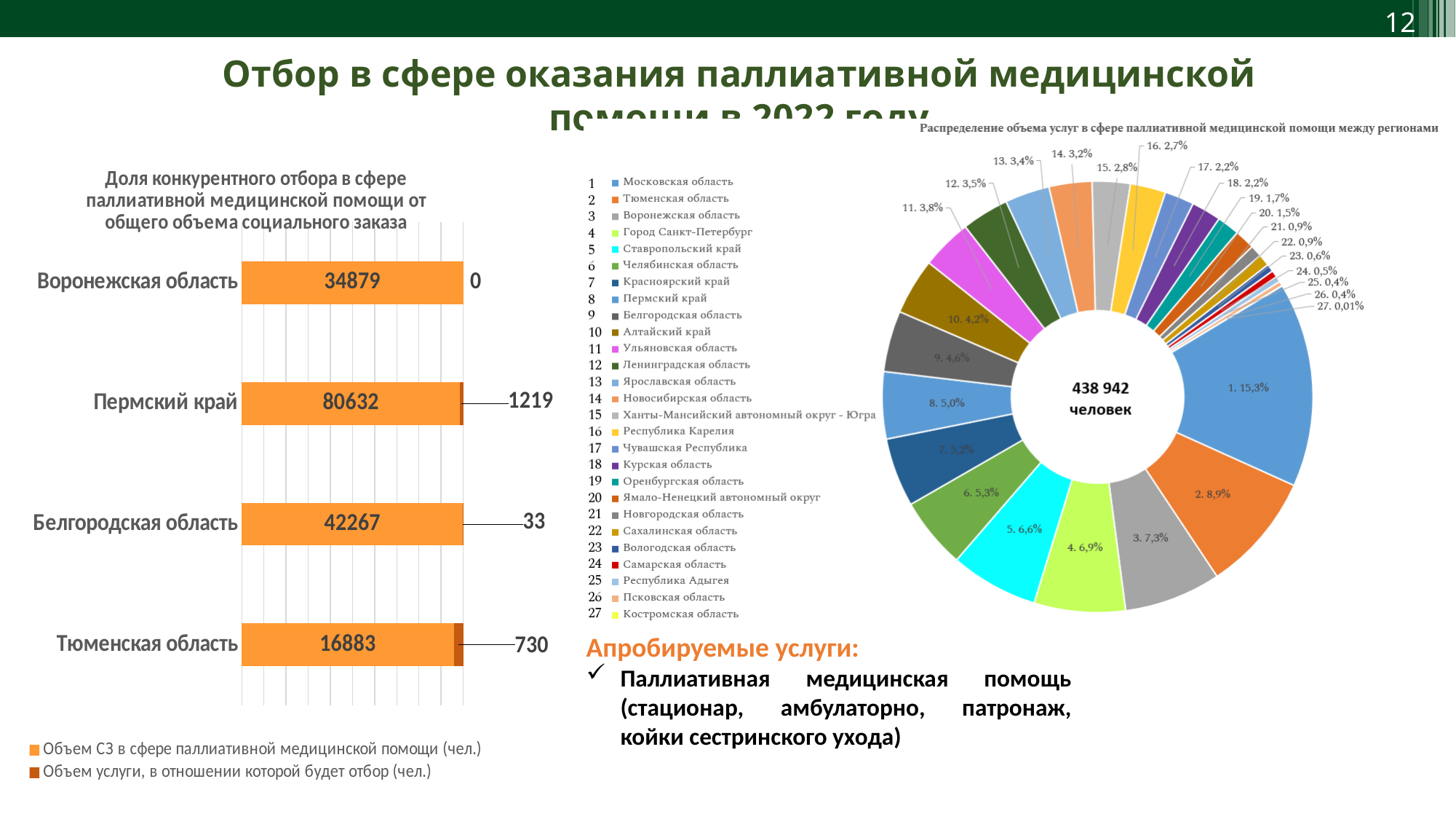
On the bar chart on the left, what is the value of 'Объем СЗ в сфере паллиативной медицинской помощи (чел.)' for Пермский край? 80632 On the bar chart on the left, what is the value of 'Объем услуги, в отношении которой будет отбор (чел.)' for Тюменская область? 730 On the bar chart on the left, which region has the lowest value of 'Объем СЗ в сфере паллиативной медицинской помощи (чел.)'? Тюменская область On the pie chart 'Распределение объема услуг в сфере паллиативной медицинской помощи между регионами', what share does Московская область (1) have? 15,3% On the bar chart on the left, what is the difference between the 'Объем СЗ' values for Белгородская область and Воронежская область? 7388 On the bar chart on the left, how many regions are shown? 4 On the pie chart 'Распределение объема услуг в сфере паллиативной медицинской помощи между регионами', what total number of people is shown in the centre? 438 942 человек On the pie chart 'Распределение объема услуг в сфере паллиативной медицинской помощи между регионами', which region has the smallest share? Костромская область What type of chart is the chart on the left of the slide? Bar chart On the bar chart on the left, which region has the highest value of 'Объем СЗ в сфере паллиативной медицинской помощи (чел.)'? Пермский край On the bar chart on the left, how many series does the legend list? 2 On the bar chart on the left, what is the total of the two stacked values for Пермский край? 81851